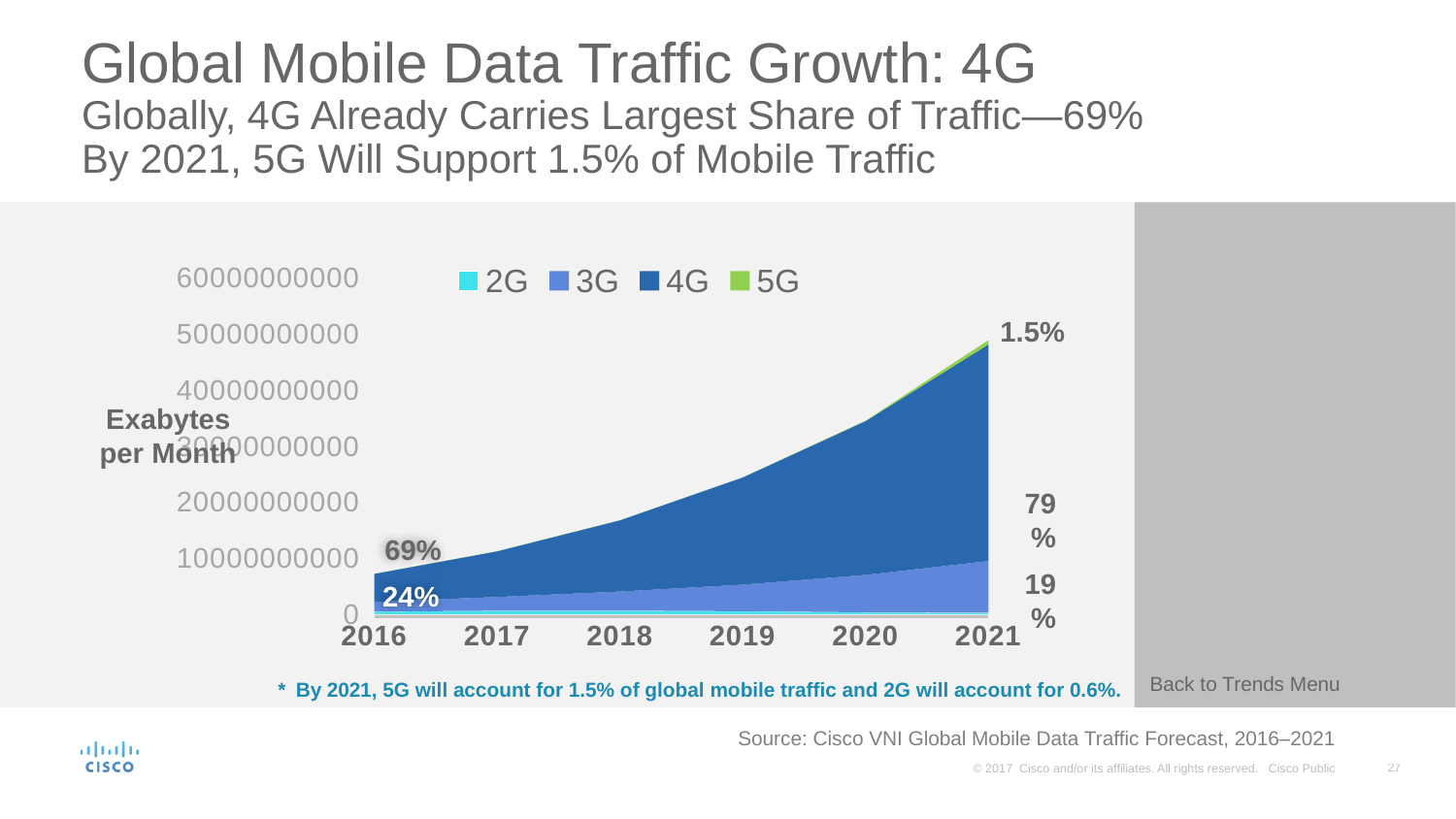
What share of mobile traffic does the chart label for 4G in 2016? 69% What kind of chart is shown on the slide? Stacked area chart How many years are shown along the x axis of the chart? 6 Which series are listed in the chart legend? 2G, 3G, 4G, 5G Does total mobile data traffic rise or fall from 2016 to 2021 in the chart? Rise What share of mobile traffic does the chart label for 4G in 2021? 79% In 2016, which has the larger labelled share of traffic, 4G or 3G? 4G What share of mobile traffic does the chart label for 3G in 2016? 24% How many series does the chart legend list? 4 What share of mobile traffic does the chart label for 5G in 2021? 1.5% By how many percentage points does the labelled 4G share in 2021 exceed the labelled 4G share in 2016? 10 percentage points Is the total traffic in 2016 greater or less than 10000000000? less